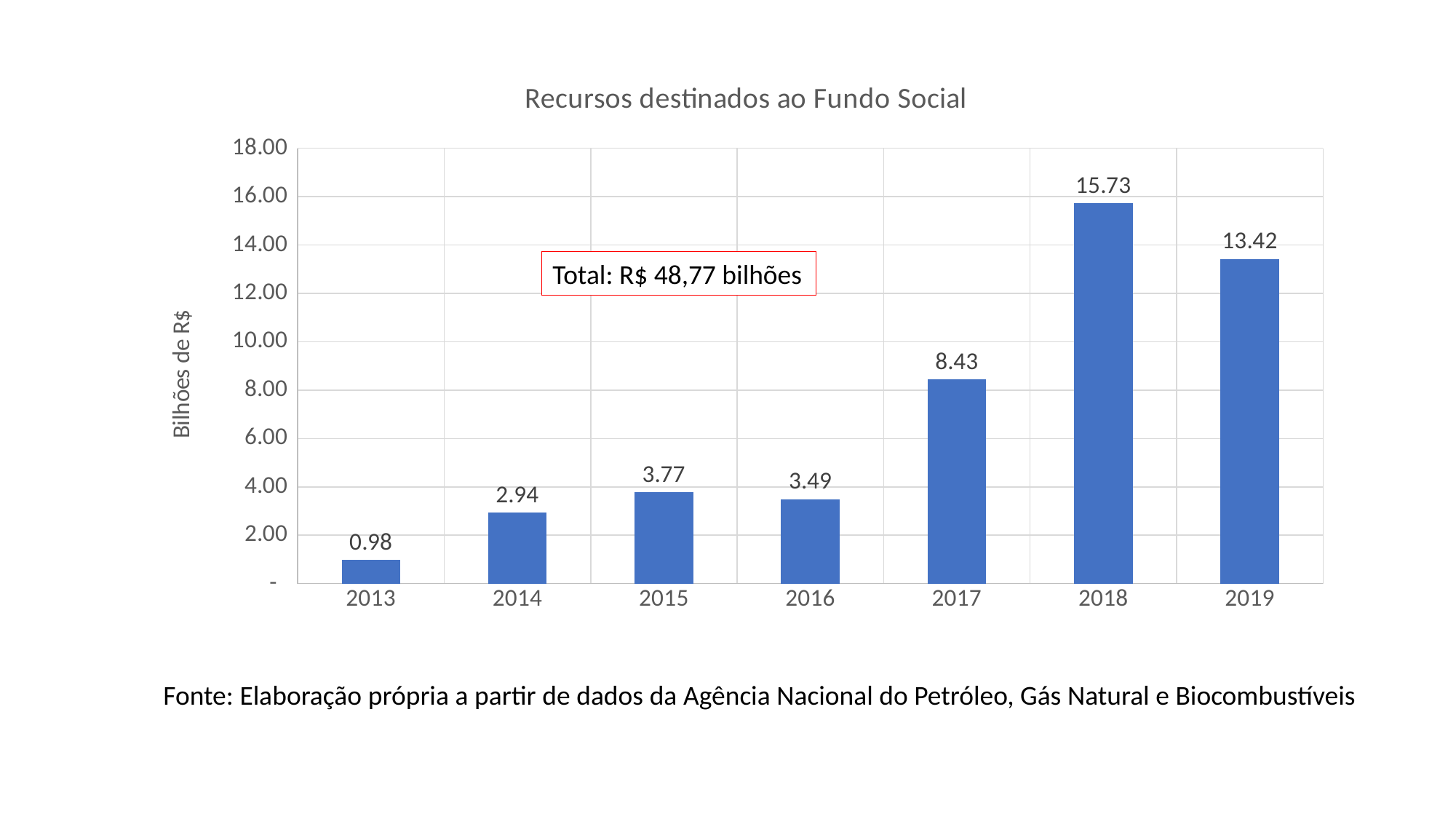
What is the value for 2016? 3.49 What kind of chart is shown? bar chart Is the value for 2017 greater or less than 8.00? greater How many years are shown on the x axis? 7 What is the difference between the values for 2018 and 2019? 2.31 What is the value for 2013? 0.98 Which year has the highest value? 2018 What is the difference between the values for 2017 and 2016? 4.94 What is the value for 2018? 15.73 What is the title of the chart? Recursos destinados ao Fundo Social Which year has the lowest value? 2013 Which is larger, the value for 2015 or the value for 2016? 2015